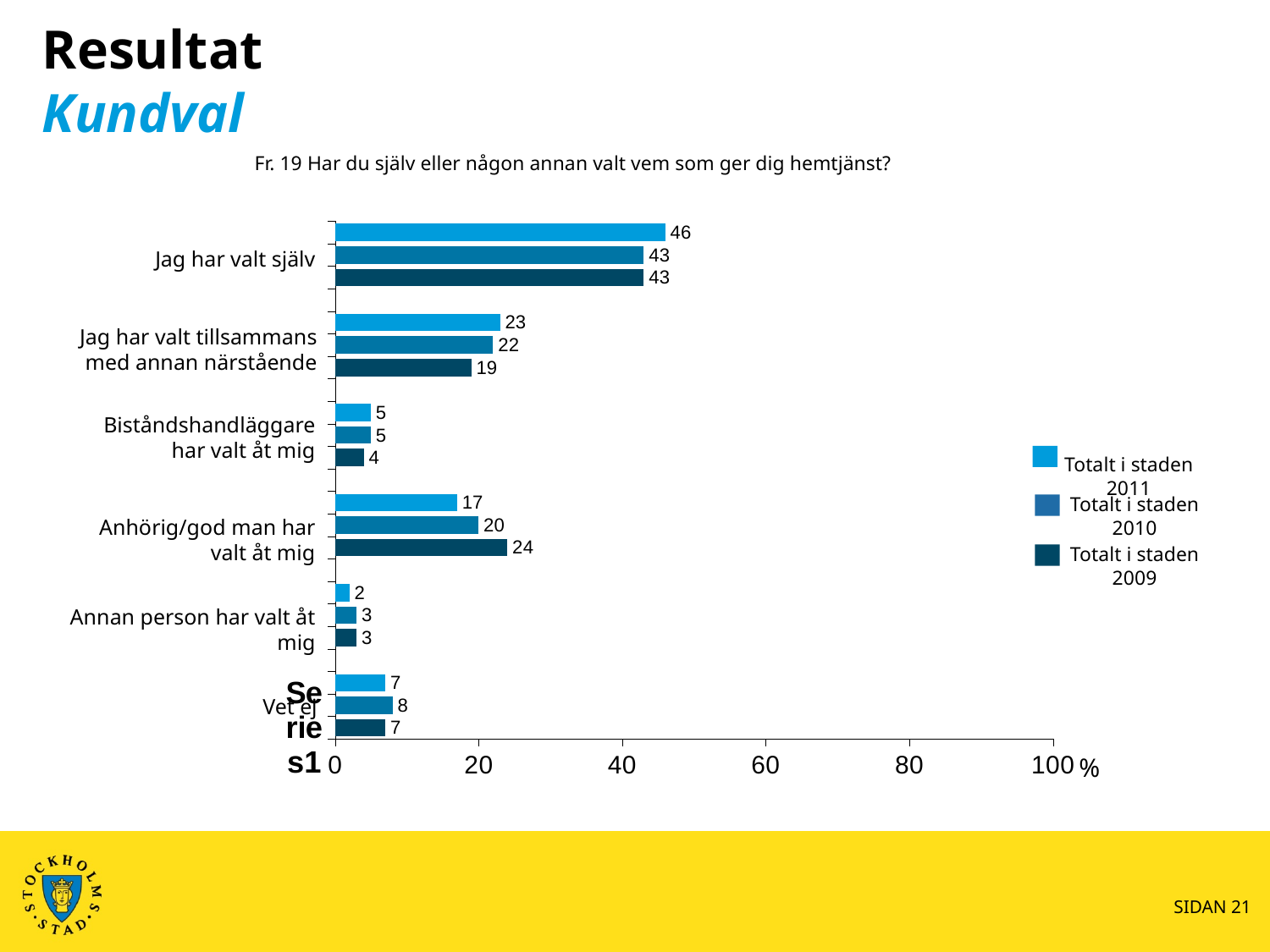
How many series does the legend list? 3 How many categories are shown on the chart? 6 What is the value for "Anhörig/god man har valt åt mig" in the Totalt i staden 2009 series? 24 Is the value for "Jag har valt själv" in the Totalt i staden 2011 series greater or less than 40? greater What is the value for "Vet ej" in the Totalt i staden 2010 series? 8 Which category has the highest value in the Totalt i staden 2011 series? Jag har valt själv What is the value for "Jag har valt själv" in the Totalt i staden 2011 series? 46 Which category has the lowest value in the Totalt i staden 2011 series? Annan person har valt åt mig Which is larger for "Jag har valt tillsammans med annan närstående": the Totalt i staden 2011 value or the Totalt i staden 2009 value? Totalt i staden 2011 What is the difference between the Totalt i staden 2011 and Totalt i staden 2009 values for "Anhörig/god man har valt åt mig"? 7 What is the value for "Jag har valt tillsammans med annan närstående" in the Totalt i staden 2010 series? 22 What kind of chart is shown on the slide? Bar chart